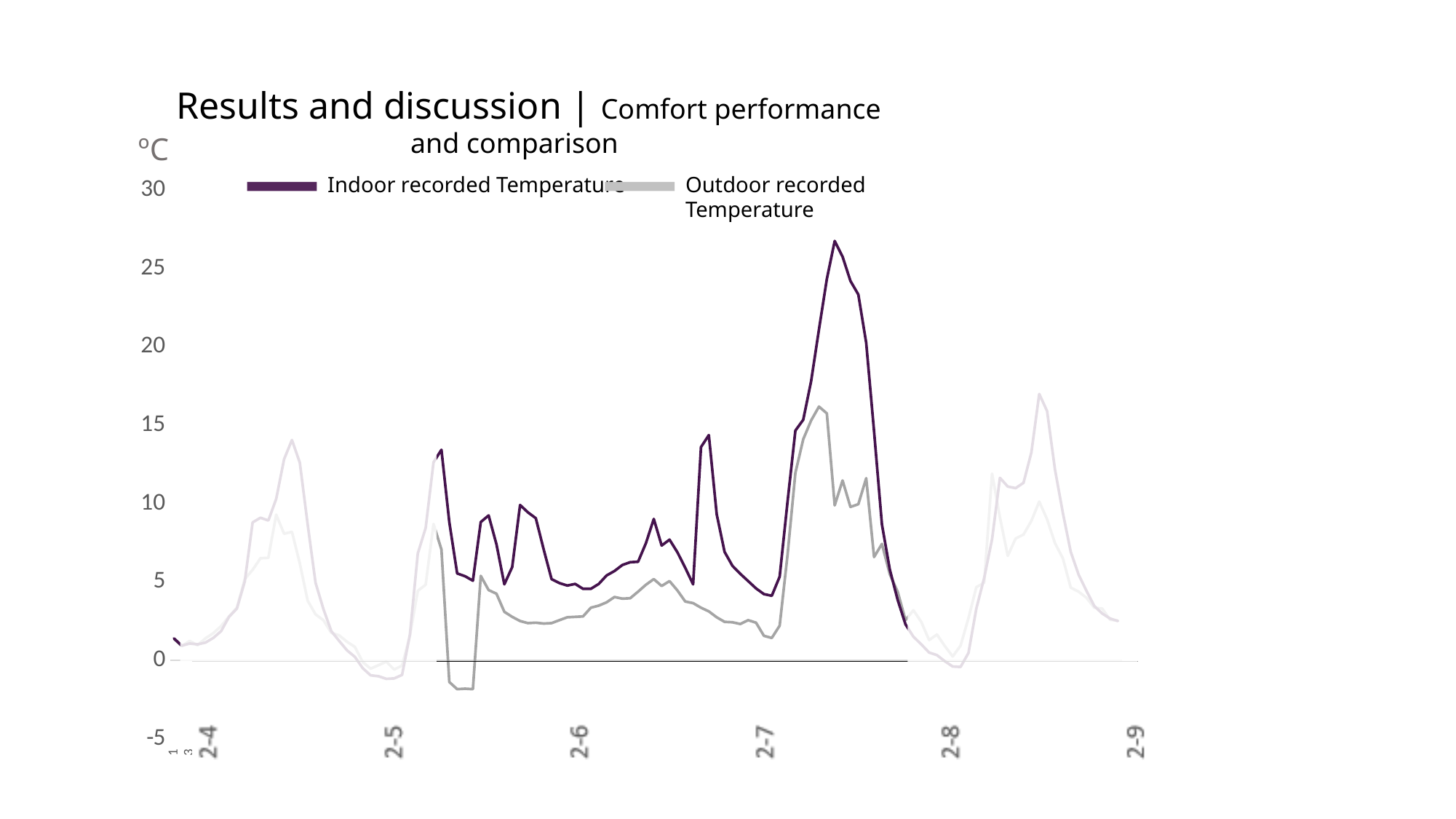
What are the two series named in the legend? Indoor recorded Temperature and Outdoor recorded Temperature Is the highest value of the Indoor recorded Temperature line greater or less than 25? greater What unit is shown at the top of the y axis? °C Is the highest value of the Outdoor recorded Temperature line greater or less than 20? less What kind of chart is shown on the slide? line chart What is the highest tick value shown on the y axis? 30 Which series reaches the higher peak, Indoor recorded Temperature or Outdoor recorded Temperature? Indoor recorded Temperature Is the lowest value of the Outdoor recorded Temperature line greater or less than 0? less Between which two x-axis dates does the Indoor recorded Temperature line reach its highest peak? 2-7 and 2-8 How many series does the legend list? 2 How many date labels are shown on the x axis? 6